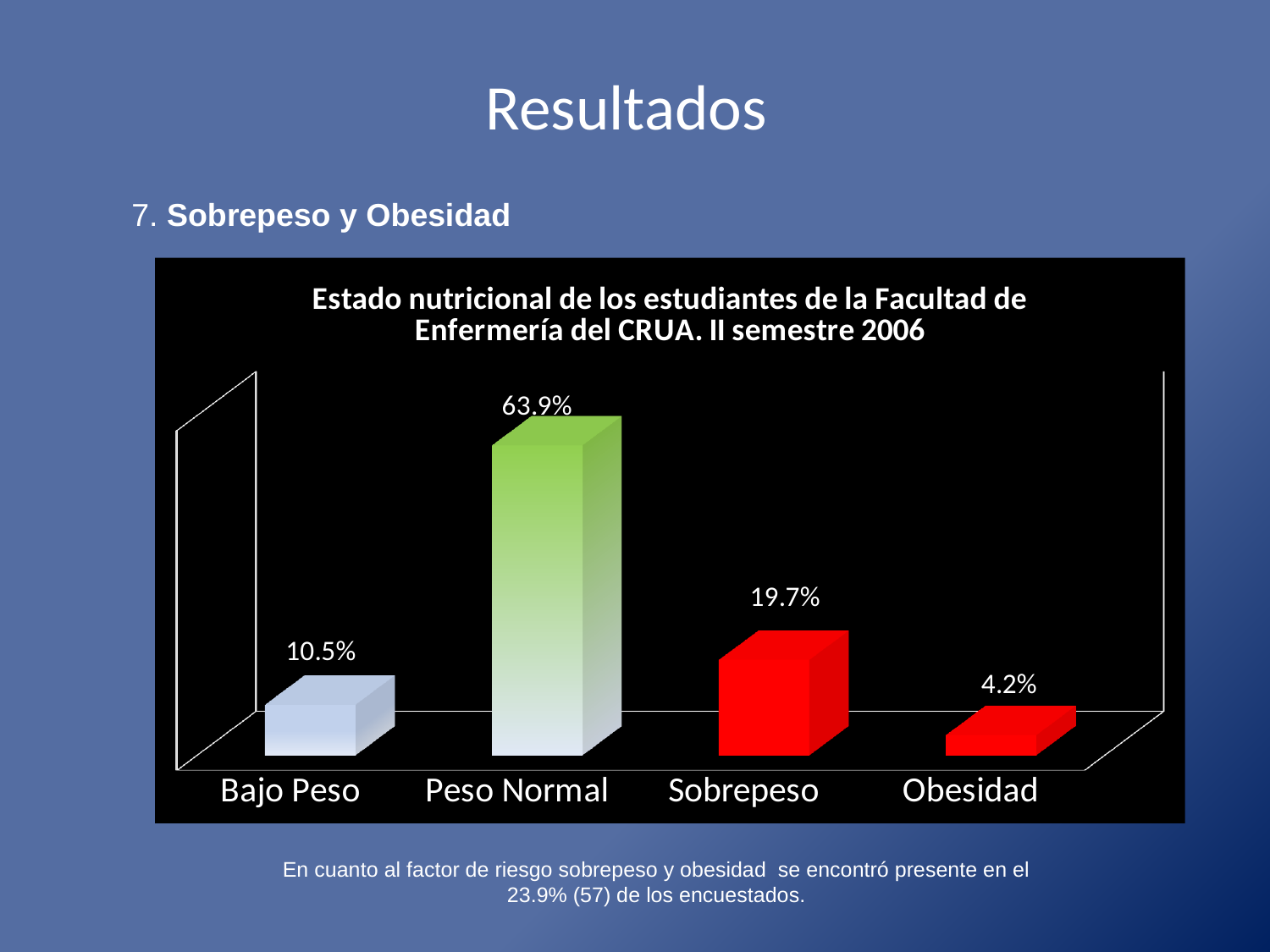
Which is larger, the value for Bajo Peso or the value for Sobrepeso? Sobrepeso What is the value for Sobrepeso? 19.7% What is the value for Peso Normal? 63.9% What kind of chart is shown on the slide? Bar chart What is the title of the chart? Estado nutricional de los estudiantes de la Facultad de Enfermería del CRUA. II semestre 2006 What is the value for Bajo Peso? 10.5% Which category has the highest value? Peso Normal What is the value for Obesidad? 4.2% How many categories are shown in the chart? 4 What is the difference between the values for Peso Normal and Sobrepeso? 44.2% Which category has the lowest value? Obesidad What is the difference between the values for Sobrepeso and Obesidad? 15.5%